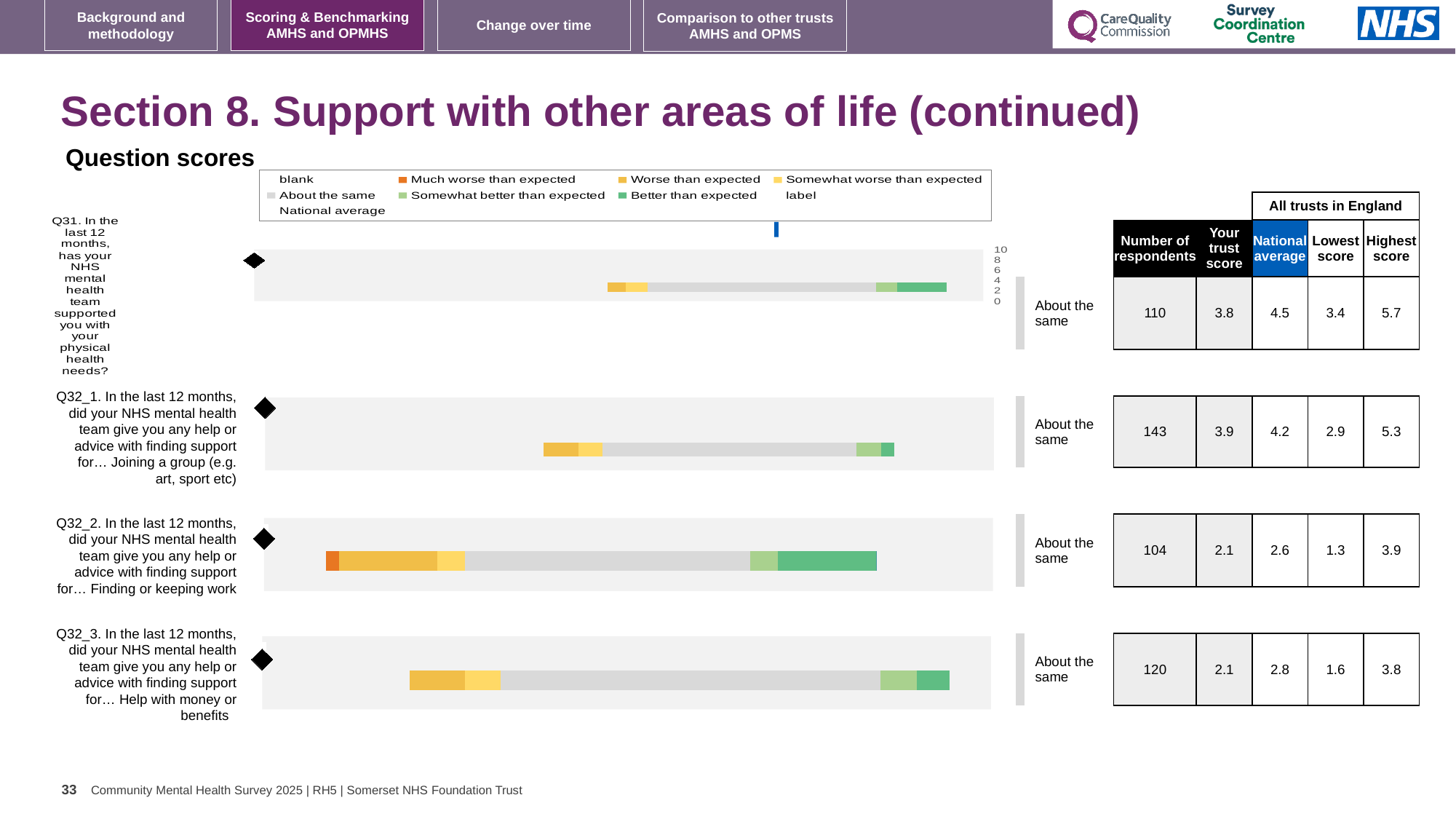
For the Q32_2 chart (finding or keeping work), what is the lowest score among all trusts in England? 1.3 For the Q31 chart (physical health needs), what is the number of respondents shown in the table? 110 For the Q32_1 chart (joining a group), what is the national average? 4.2 Which question has the highest number of respondents? Q32_1 (Joining a group) How many question score charts are shown on the slide? 4 What kind of chart is used to show the question scores on this slide? bar chart For the Q32_3 chart (help with money or benefits), what is the highest score among all trusts in England? 3.8 In the legend, what colour represents 'About the same'? Grey For the Q31 chart (physical health needs), what is the trust score? 3.8 What benchmark category label is shown next to each of the four charts? About the same For the Q31 chart, what is the difference between the highest score and the lowest score? 2.3 For the Q31 chart, which is larger: the trust score or the national average? National average